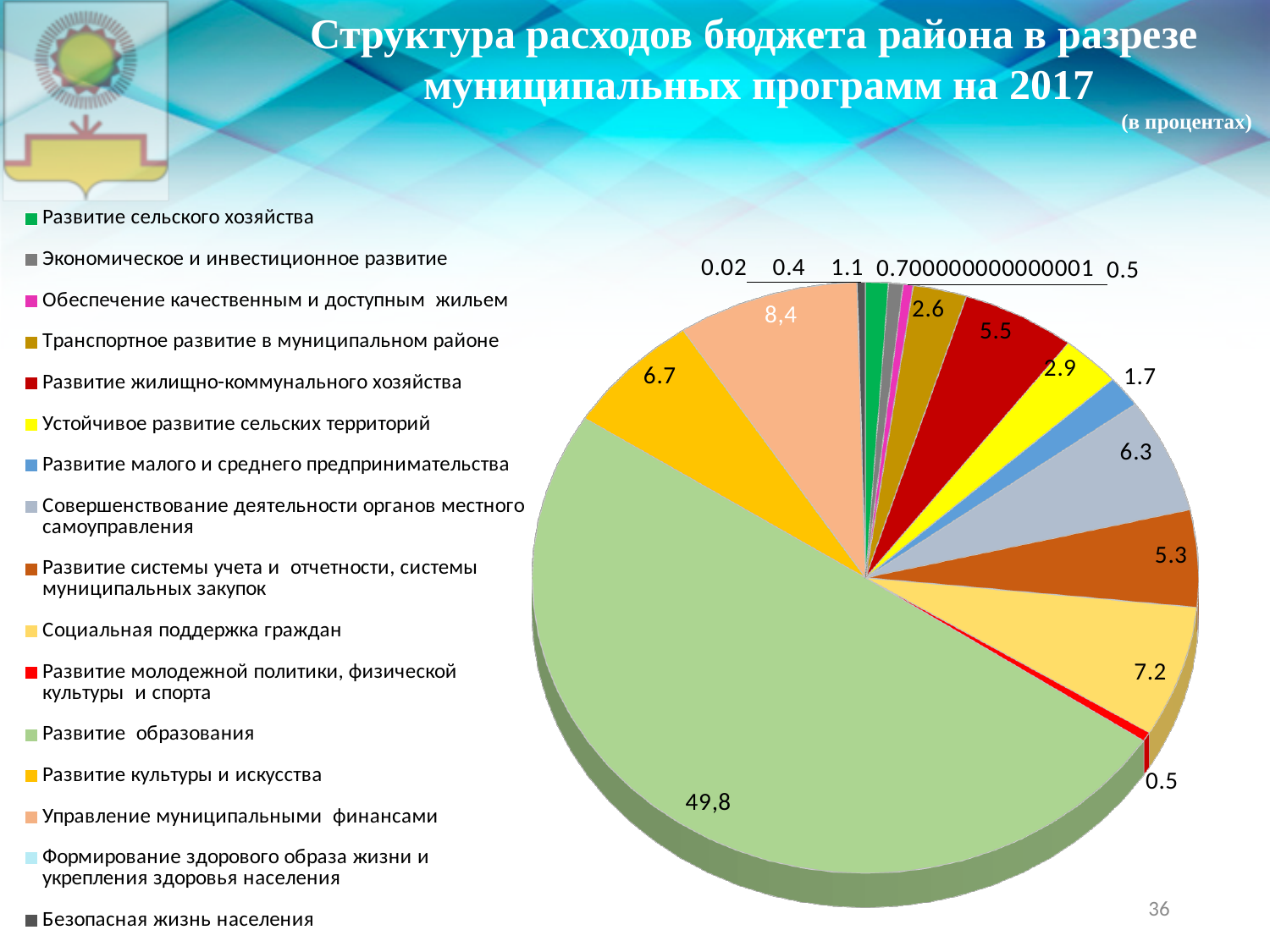
What is the value shown for Развитие жилищно-коммунального хозяйства? 5.5 What is the value shown for Развитие культуры и искусства? 6.7 What is the value shown for Развитие малого и среднего предпринимательства? 1.7 Which program has the largest share of the budget expenditure? Развитие образования What is the value shown for Развитие образования? 49,8 What kind of chart is shown on the slide? pie chart In what units are the values on the chart expressed, according to the slide? в процентах What is the value shown for Управление муниципальными финансами? 8,4 What is the value shown for Социальная поддержка граждан? 7.2 Which is larger: the value for Совершенствование деятельности органов местного самоуправления or the value for Устойчивое развитие сельских территорий? Совершенствование деятельности органов местного самоуправления What is the difference between the values for Социальная поддержка граждан (7.2) and Развитие системы учета и отчетности, системы муниципальных закупок (5.3)? 1.9 How many entries does the legend list? 16